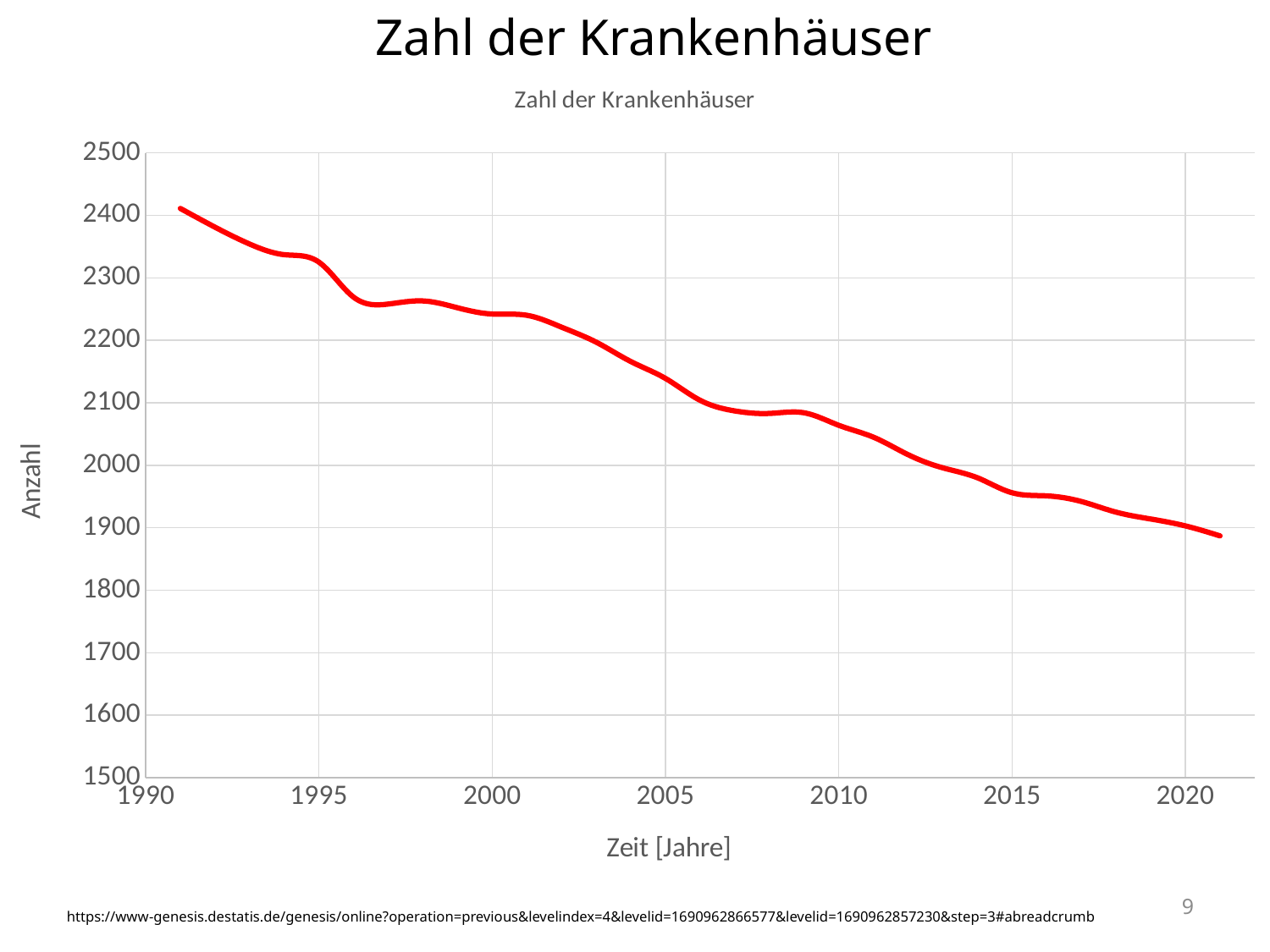
Is the value for 2010 greater or less than 2000? greater Is the value for 2005 greater or less than 2200? less What is the label of the x axis? Zeit [Jahre] Which is larger, the value for 1995 or the value for 2015? 1995 What is the label of the y axis? Anzahl Do the values rise or fall along the x axis from 1990 to 2020? fall What kind of chart is shown on the slide? line chart Is the value for 2010 greater or less than 2100? less